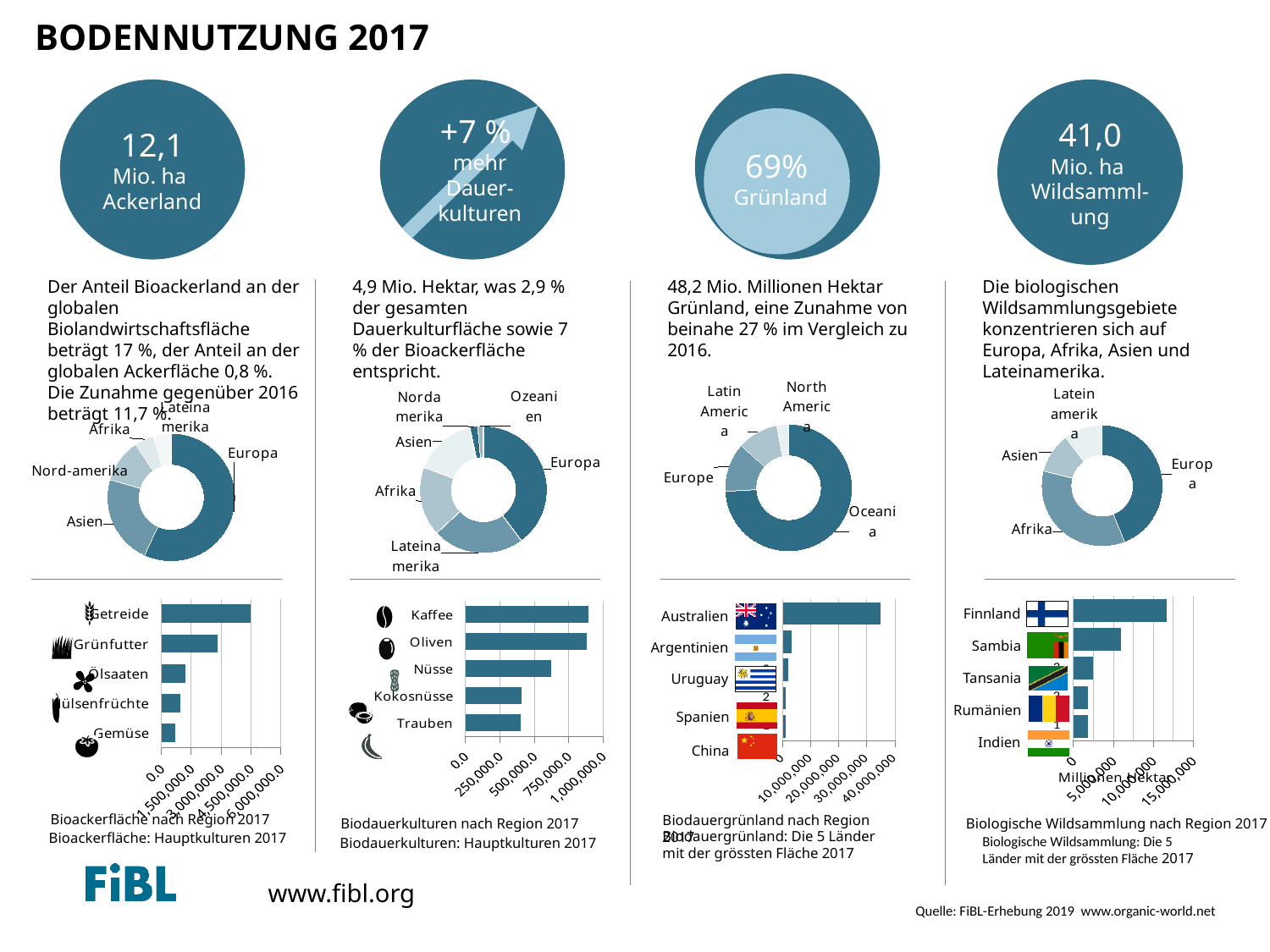
In the chart 'Bioackerfläche: Hauptkulturen 2017', which crop has the highest value? Getreide In the chart 'Bioackerfläche: Hauptkulturen 2017', which crop has the lowest value? Gemüse How many crops are shown in the chart 'Biodauerkulturen: Hauptkulturen 2017'? 5 In the chart 'Biodauergrünland nach Region 2017', which region has the largest share? Oceania In the chart 'Biologische Wildsammlung: Die 5 Länder mit der grössten Fläche 2017', which country has the highest value? Finnland What kind of chart is 'Bioackerfläche nach Region 2017'? Donut chart In the chart 'Biologische Wildsammlung: Die 5 Länder mit der grössten Fläche 2017', is the value for Tansania greater or less than 5,000,000? less In the chart 'Biodauerkulturen: Hauptkulturen 2017', is the value for Kokosnüsse greater or less than 500,000? less In the chart 'Biodauergrünland: Die 5 Länder mit der grössten Fläche 2017', is the value for Argentinien greater or less than 10,000,000? less